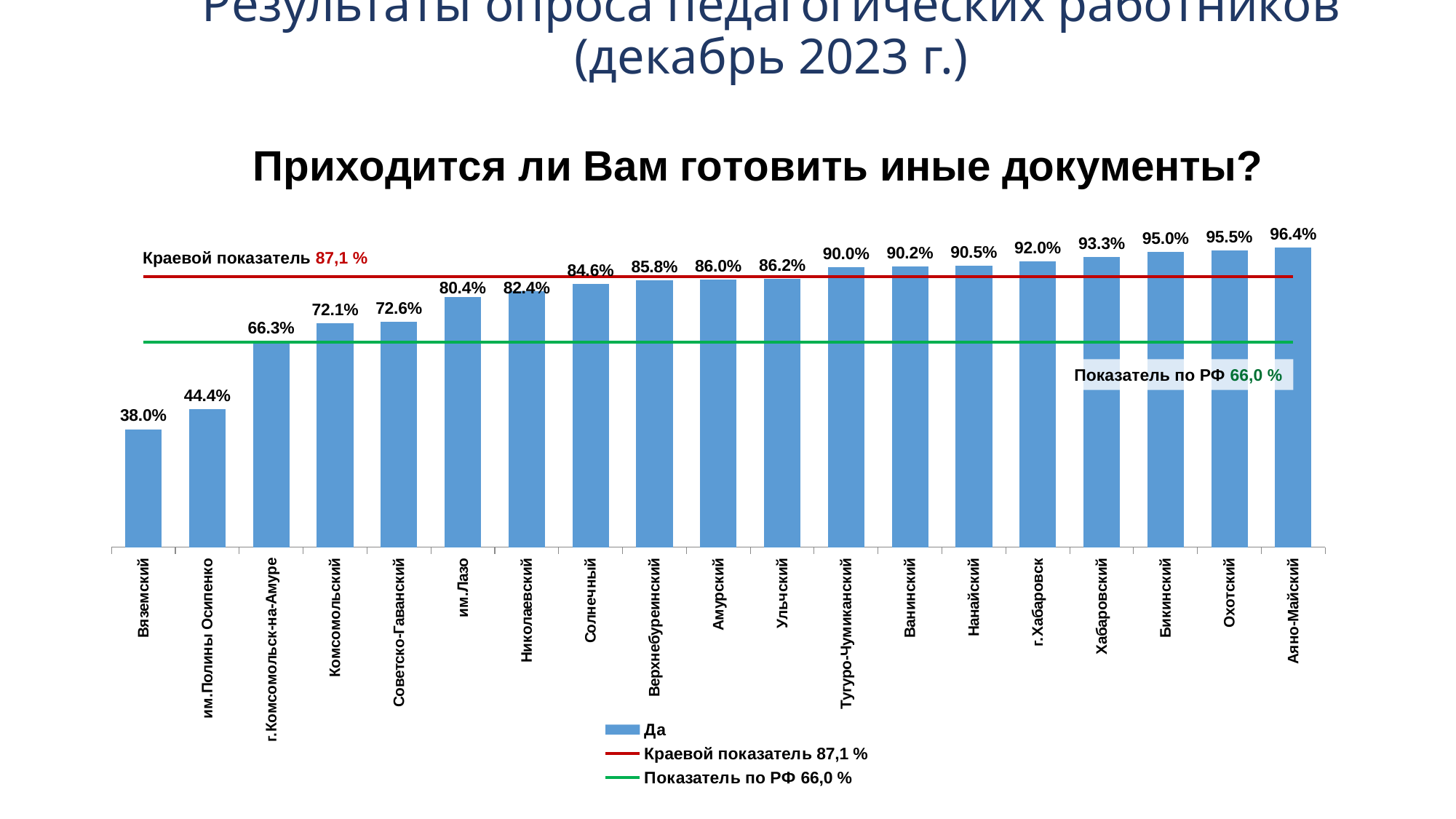
What is the value for Ульчский? 86.2% Which is larger, the value for Комсомольский or the value for Советско-Гаванский? Советско-Гаванский What kind of chart is shown on the slide? bar chart Which category has the highest value? Аяно-Майский What is the value for Вяземский? 38.0% What is the difference between the values for Охотский and Бикинский? 0.5% What is the value for г.Хабаровск? 92.0% How many entries does the legend list? 3 What value does the red line labelled Краевой показатель represent? 87,1 % How many categories are shown on the x axis? 19 What is the difference between the values for им.Полины Осипенко and Вяземский? 6.4% Which category has the lowest value? Вяземский